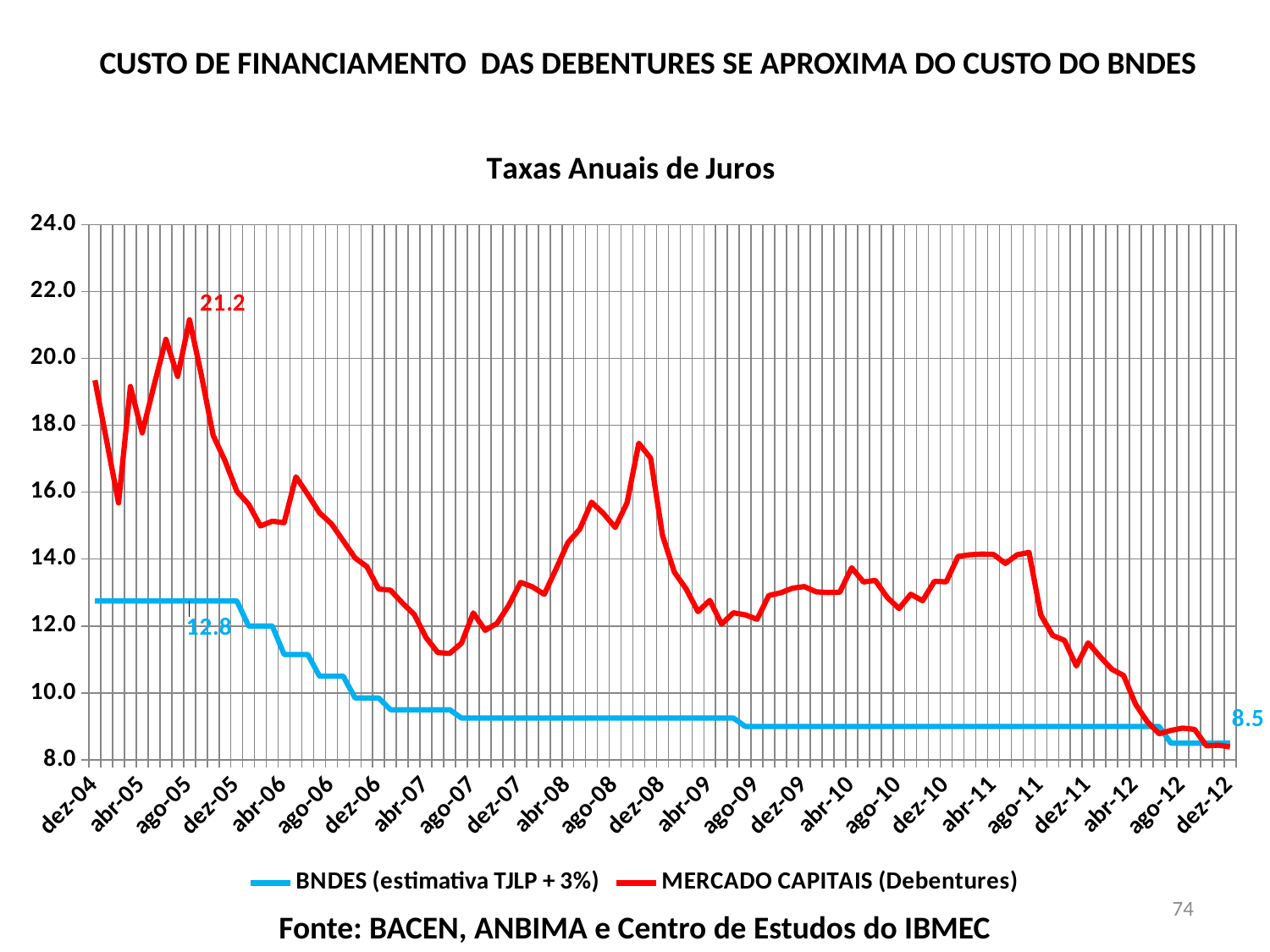
Is the value of MERCADO CAPITAIS (Debentures) at dez-08 greater or less than 16.0? less What is the title of the chart? Taxas Anuais de Juros Is the value of BNDES (estimativa TJLP + 3%) at ago-09 greater or less than 10.0? less What value is labelled on the BNDES (estimativa TJLP + 3%) line at dez-12? 8.5 By how much did the BNDES (estimativa TJLP + 3%) rate fall from its labelled starting value (12.8) to its labelled ending value (8.5)? 4.3 At dez-04, which series has the higher value, BNDES or MERCADO CAPITAIS (Debentures)? MERCADO CAPITAIS (Debentures) What value is labelled on the BNDES (estimativa TJLP + 3%) line at the start of the series (dez-04)? 12.8 Does the BNDES (estimativa TJLP + 3%) line rise or fall from dez-04 to dez-12? fall What is the peak value labelled on the MERCADO CAPITAIS (Debentures) line? 21.2 What kind of chart is shown on the slide? line chart Which series reaches the highest value anywhere on the chart? MERCADO CAPITAIS (Debentures) How many series does the legend list? 2